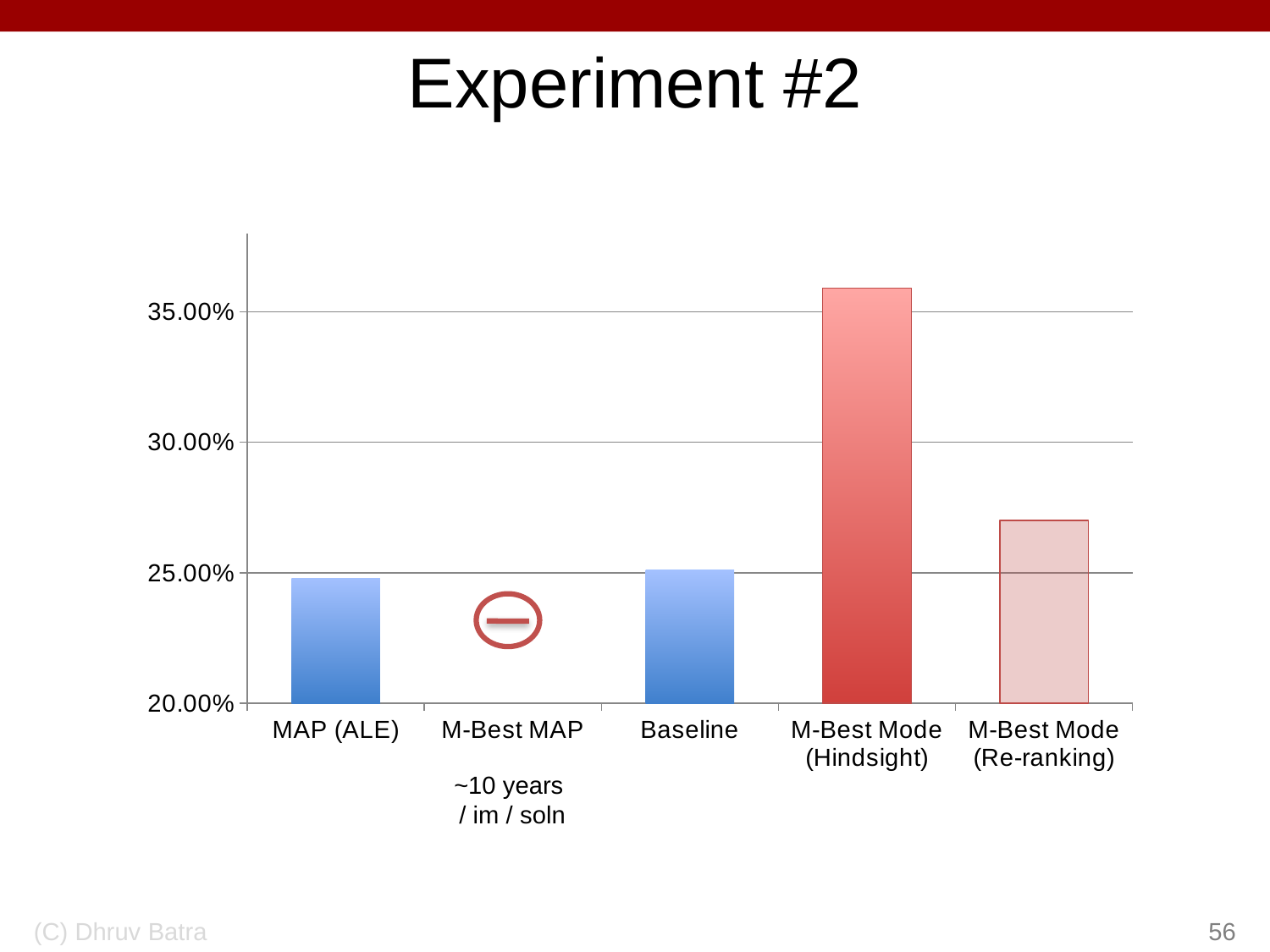
Which is larger, the value for M-Best Mode (Hindsight) or the value for M-Best Mode (Re-ranking)? M-Best Mode (Hindsight) What is the title of the slide containing the chart? Experiment #2 Is the value for M-Best Mode (Re-ranking) greater or less than 30.00%? less What kind of chart is shown on the slide? bar chart Is the value for M-Best Mode (Re-ranking) greater or less than 25.00%? greater Is the value for MAP (ALE) greater or less than 25.00%? less Which is larger, the value for M-Best Mode (Re-ranking) or the value for Baseline? M-Best Mode (Re-ranking) Which category on the x axis has no bar plotted? M-Best MAP How many categories are labelled on the x axis of the chart? 5 Which category has the highest bar in the chart? M-Best Mode (Hindsight)